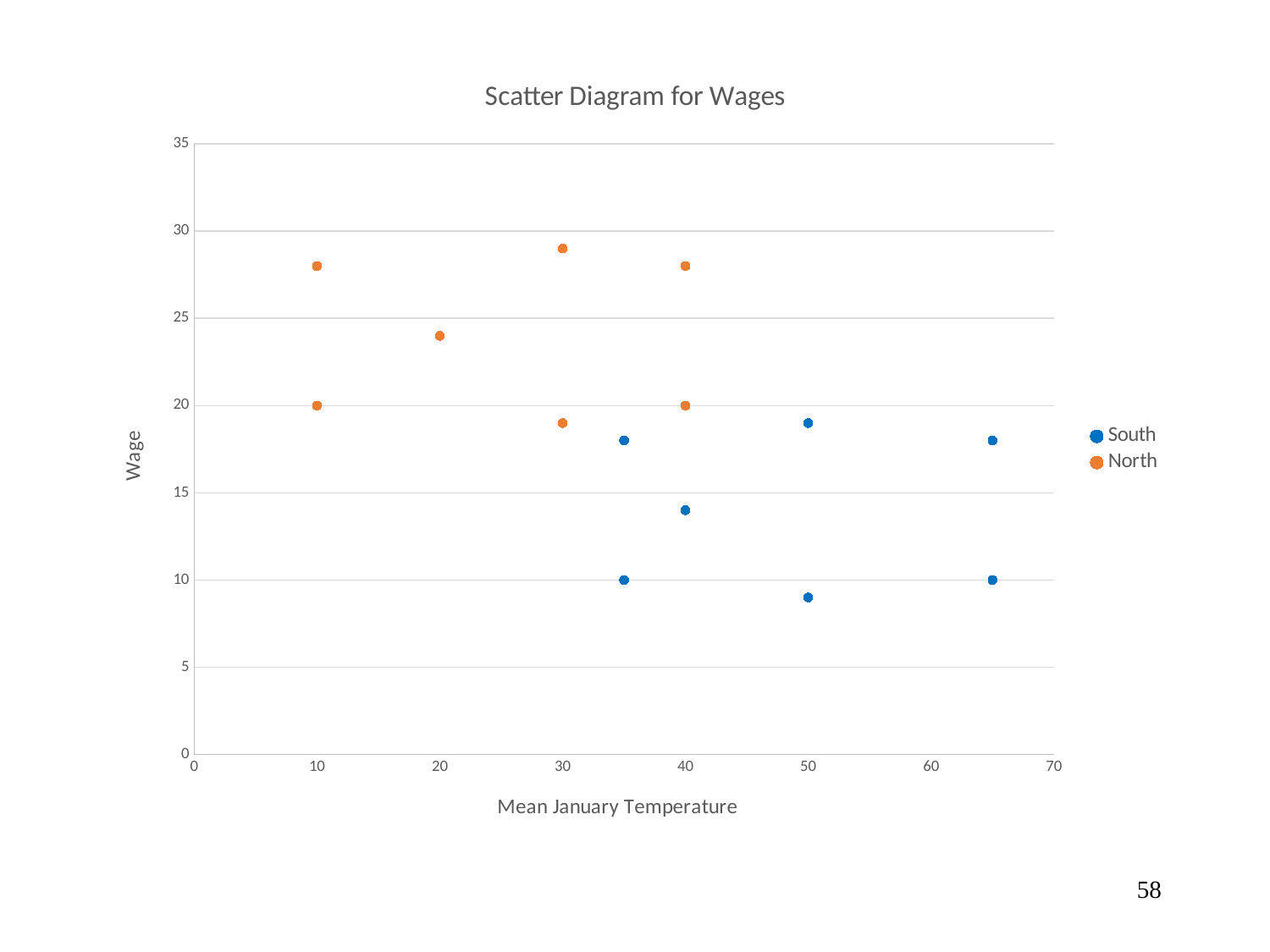
Which series contains the point with the highest wage? North What is the wage of the lower South point at a mean January temperature of 65? 10 What are the two series named in the legend? South and North How many South data points are plotted? 7 How many North data points are plotted? 7 What is the wage of the lower North point at a mean January temperature of 10? 20 What is the title of the chart? Scatter Diagram for Wages How many series does the legend list? 2 Is the wage of the South point at a mean January temperature of 40 greater or less than 15? less Which series contains the point with the lowest wage? South Is the wage of the highest North point at a mean January temperature of 30 greater or less than 25? greater What kind of chart is shown on the slide? scatter chart